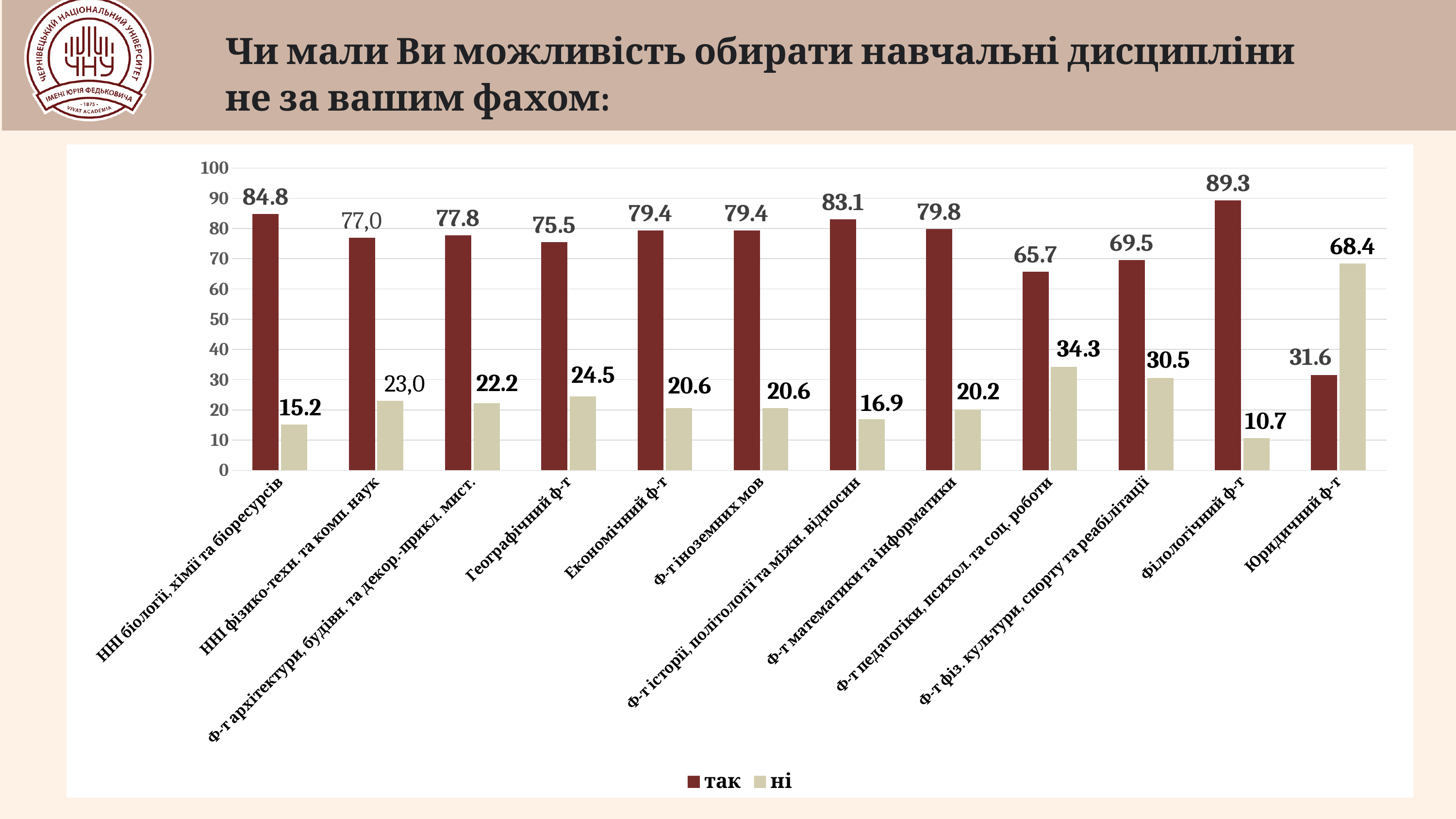
What type of chart is shown on the slide? bar chart How many series does the legend list? 2 Which is larger: the "так" value for Географічний ф-т or the "так" value for Економічний ф-т? Економічний ф-т What is the value of "ні" for ННІ фізико-техн. та комп. наук? 23,0 Which category has the highest value for "так"? Філологічний ф-т What is the value of "так" for Філологічний ф-т? 89.3 What is the difference between the "так" and "ні" values for Ф-т педагогіки, психол. та соц. роботи? 31.4 Which category has the lowest value for "так"? Юридичний ф-т How many categories are shown on the x axis? 12 Which category has the lowest value for "ні"? Філологічний ф-т Is the "ні" value for Ф-т фіз. культури, спорту та реабілітації greater or less than 40? less What is the value of "ні" for Юридичний ф-т? 68.4